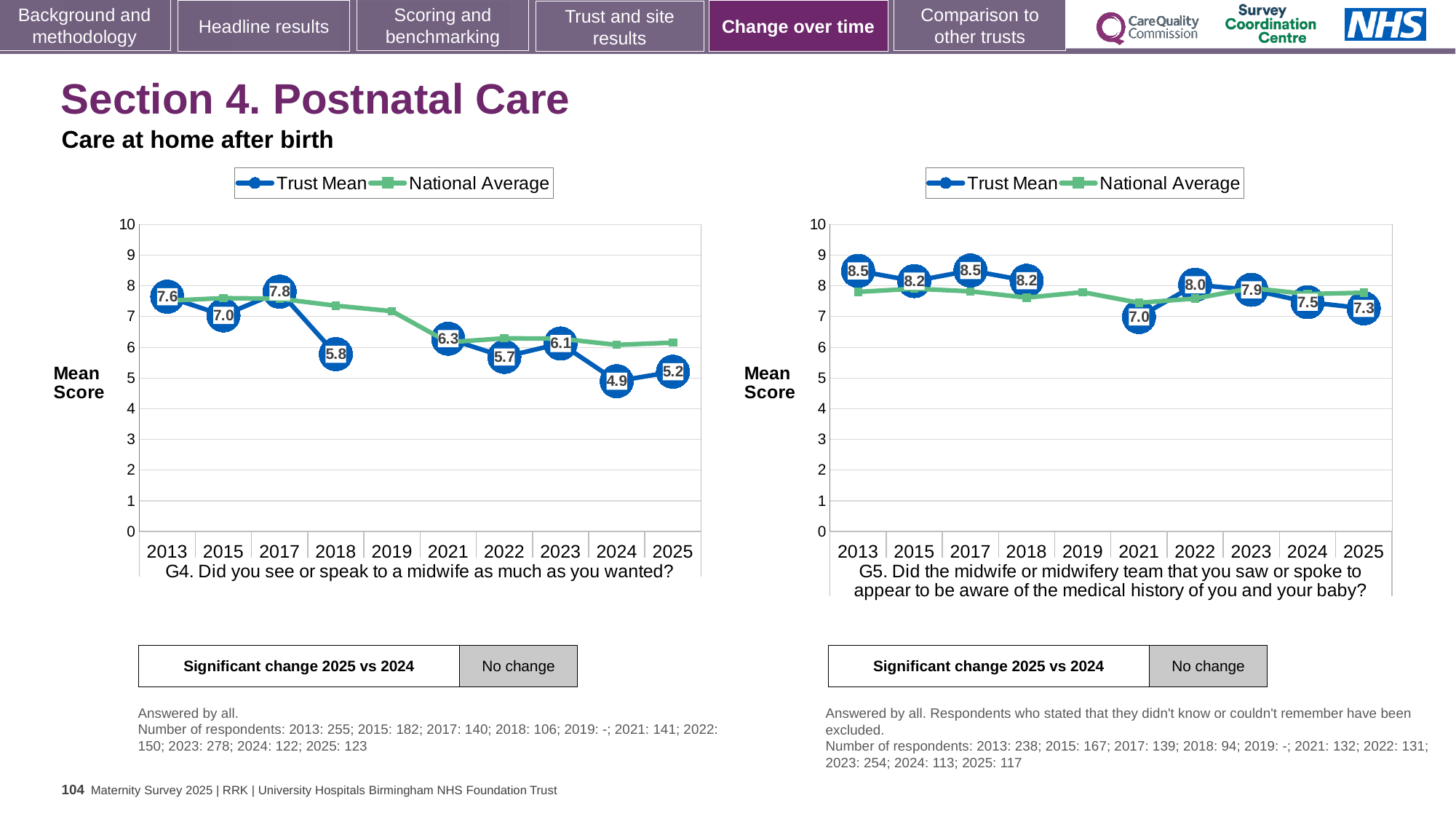
In the G5 chart on the right, which year has the lowest Trust Mean score? 2021 In the G4 chart on the left, what is the difference between the Trust Mean scores for 2017 and 2018? 2.0 In the G4 chart on the left, what is the Trust Mean score for 2024? 4.9 In the G4 chart on the left, which year has the lowest Trust Mean score? 2024 In the G5 chart on the right, what is the Trust Mean score for 2021? 7.0 In the G5 chart on the right, is the National Average value for 2013 greater or less than 8? less How many series does the legend of the G4 chart on the left list? 2 How many years are shown on the x axis of the G5 chart on the right? 10 In the G5 chart on the right, which is larger: the Trust Mean score for 2022 or for 2025? 2022 In the G4 chart on the left, which year has the highest Trust Mean score? 2017 What kind of chart is the G4 chart on the left? Line chart In the G4 chart on the left, is the National Average value for 2018 greater or less than 7? greater